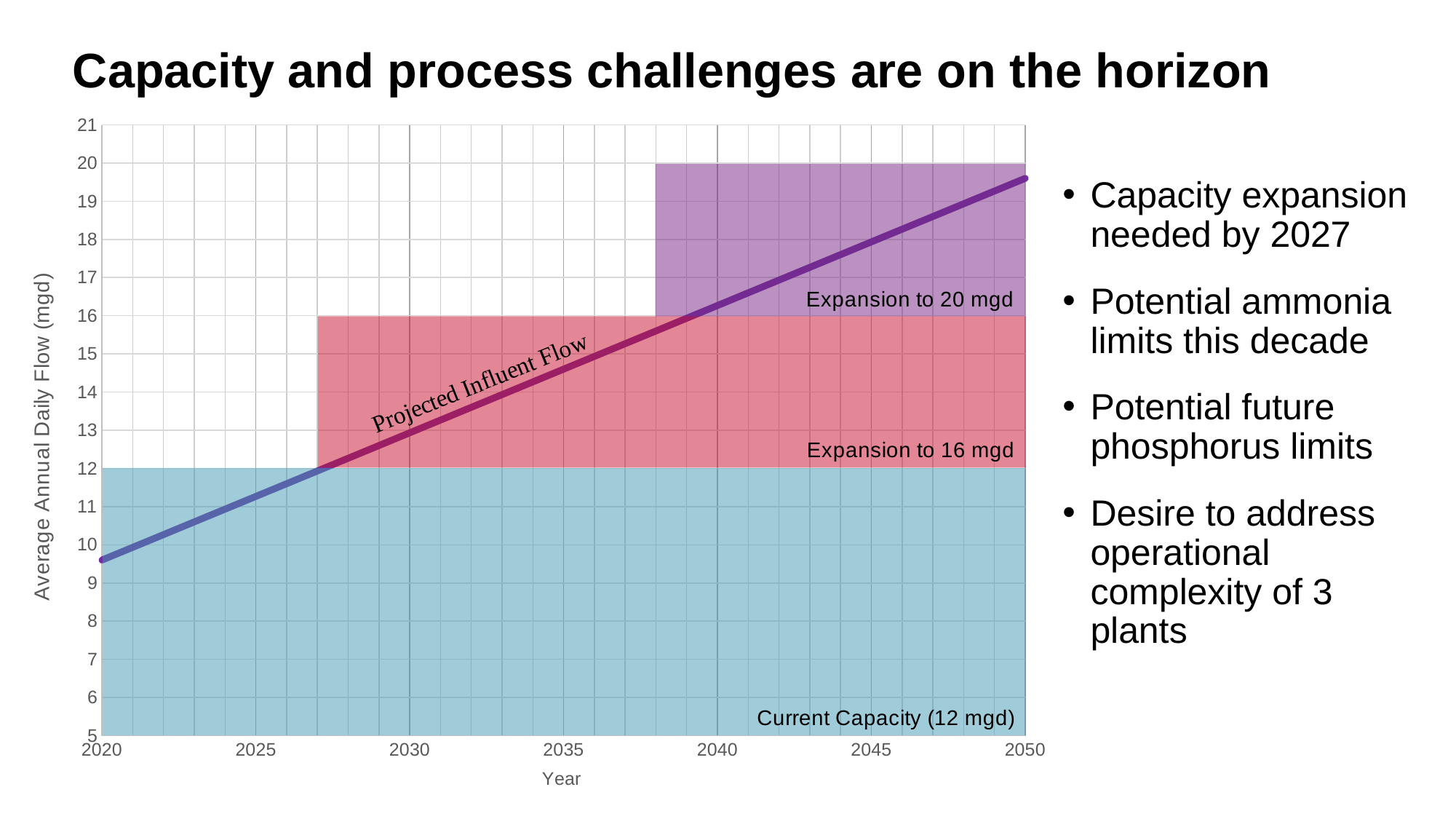
How much larger is the 16 mgd expansion than the current capacity of 12 mgd? 4 mgd Is the Projected Influent Flow in 2050 greater or less than 19? greater How many capacity levels are shaded on the chart? 3 Is the Projected Influent Flow in 2020 greater or less than 10? less Is the Projected Influent Flow in 2035 greater or less than 14? greater How much larger is the 20 mgd expansion than the 16 mgd expansion? 4 mgd Does the Projected Influent Flow line rise or fall from 2020 to 2050? rise What is the current capacity shown on the chart? 12 mgd What is the label of the y axis? Average Annual Daily Flow (mgd) What capacity does the red shaded region represent? Expansion to 16 mgd What capacity does the purple shaded region represent? Expansion to 20 mgd What kind of chart is shown on the slide? line chart